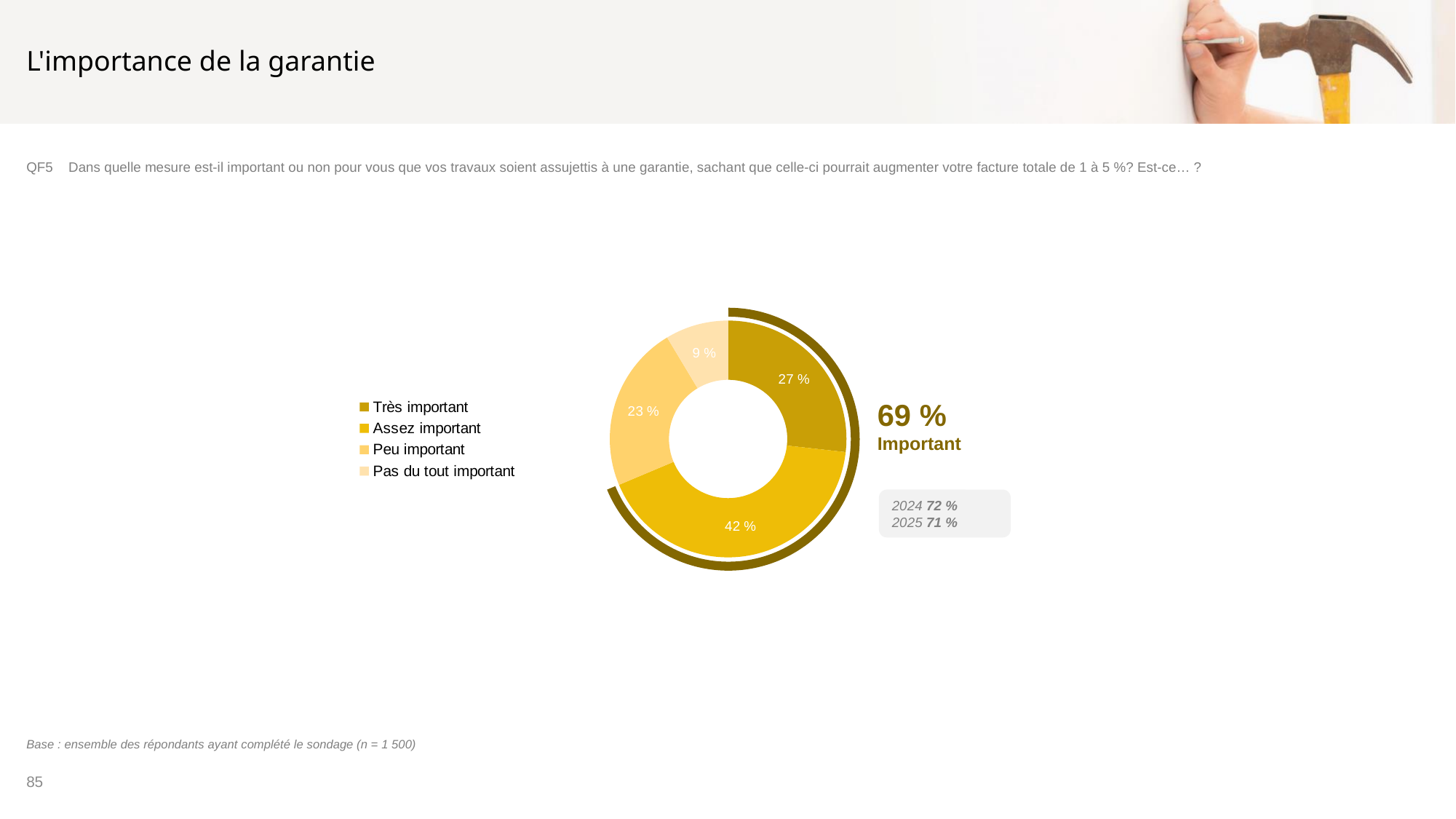
What is the value for "Pas du tout important"? 9 % What was the "Important" percentage shown for 2024? 72 % What combined percentage is labelled "Important" next to the chart? 69 % What is the value for "Peu important"? 23 % What kind of chart is shown on the slide? Pie chart (doughnut) Which category has the largest share? Assez important What is the difference between "Assez important" and "Très important"? 15 % What is the value for "Très important"? 27 % How many categories does the legend list? 4 Which category has the smallest share? Pas du tout important Which is larger, "Peu important" or "Très important"? Très important What is the value for "Assez important"? 42 %